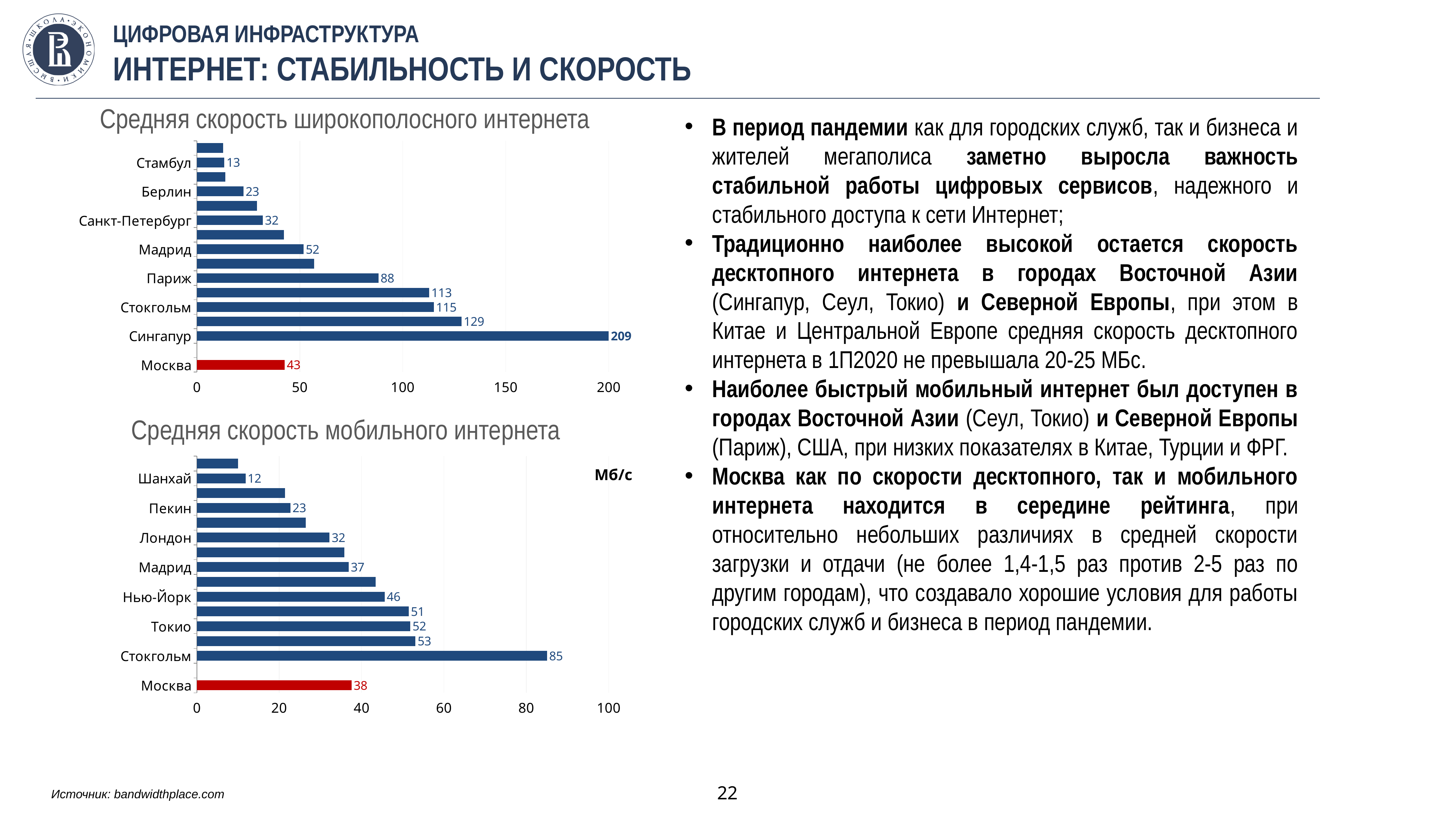
In the 'Средняя скорость широкополосного интернета' chart, what is the value for Стокгольм? 115 In the 'Средняя скорость мобильного интернета' chart, what is the difference between Стокгольм and Москва? 47 In the 'Средняя скорость мобильного интернета' chart, what is the value for Стокгольм? 85 In the 'Средняя скорость широкополосного интернета' chart, which is larger, the value for Мадрид or the value for Москва? Мадрид In the 'Средняя скорость мобильного интернета' chart, which labelled city has the highest value? Стокгольм In the 'Средняя скорость широкополосного интернета' chart, which labelled city has the highest value? Сингапур In the 'Средняя скорость мобильного интернета' chart, what is the value for Москва? 38 In the 'Средняя скорость широкополосного интернета' chart, what is the difference between Сингапур and Москва? 166 In the 'Средняя скорость мобильного интернета' chart, what colour is the bar for Москва? Red In the 'Средняя скорость широкополосного интернета' chart, what is the value for Москва? 43 What kind of chart is the 'Средняя скорость широкополосного интернета' chart? Bar chart In the 'Средняя скорость широкополосного интернета' chart, what is the value for Сингапур? 209